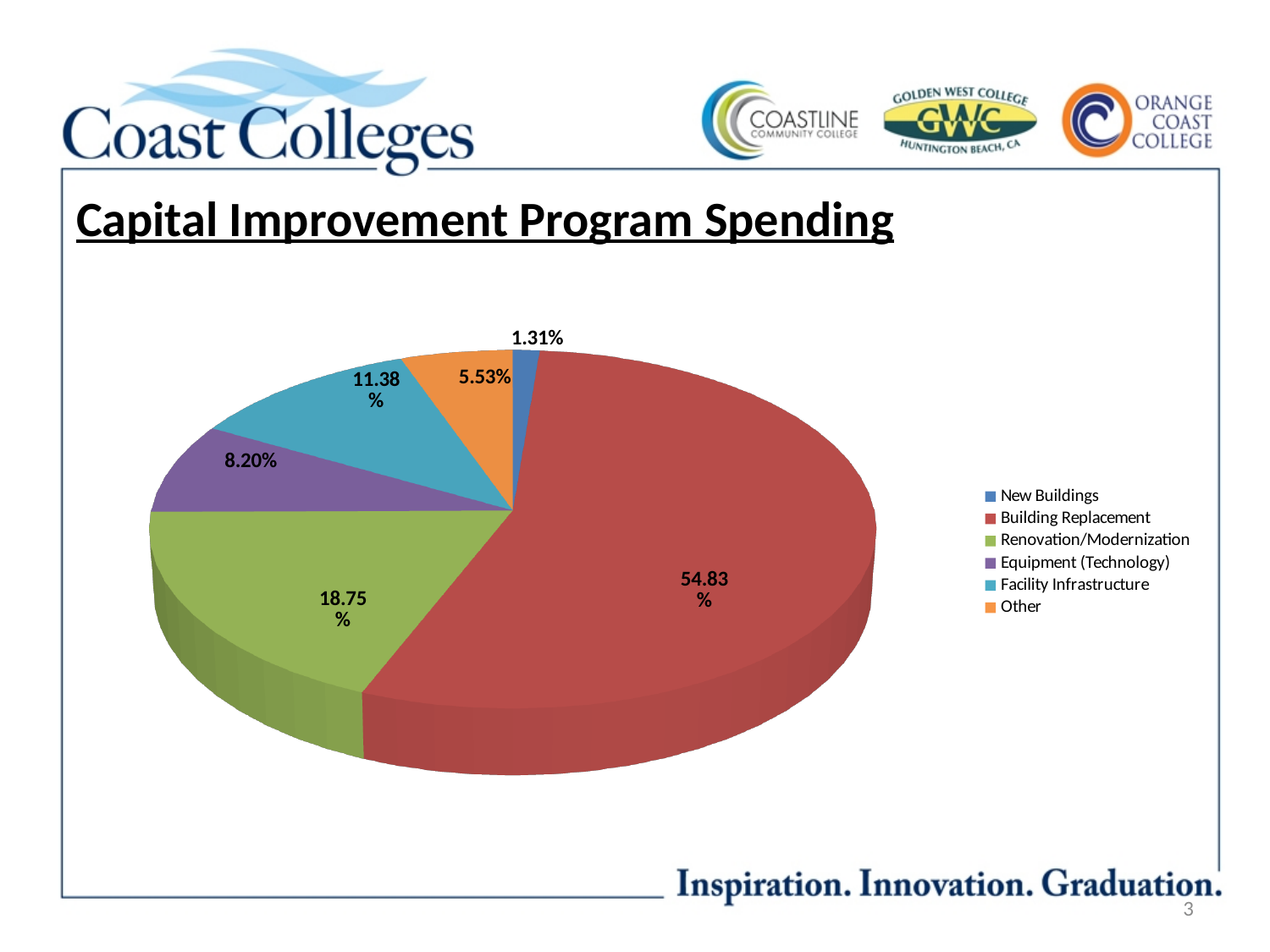
Which is larger, the share for Facility Infrastructure or the share for Other? Facility Infrastructure Which category has the largest share of Capital Improvement Program Spending? Building Replacement Which category has the smallest share of Capital Improvement Program Spending? New Buildings What percentage of spending is for Renovation/Modernization? 18.75% What percentage of spending is for Equipment (Technology)? 8.20% What share of Capital Improvement Program Spending goes to Building Replacement? 54.83% What percentage of spending is for New Buildings? 1.31% How many categories does the pie chart show? 6 What is the difference in percentage points between Building Replacement and Renovation/Modernization? 36.08 What type of chart is shown on the slide? Pie chart What percentage of spending is for Facility Infrastructure? 11.38% Which category is shown in orange in the pie chart? Other